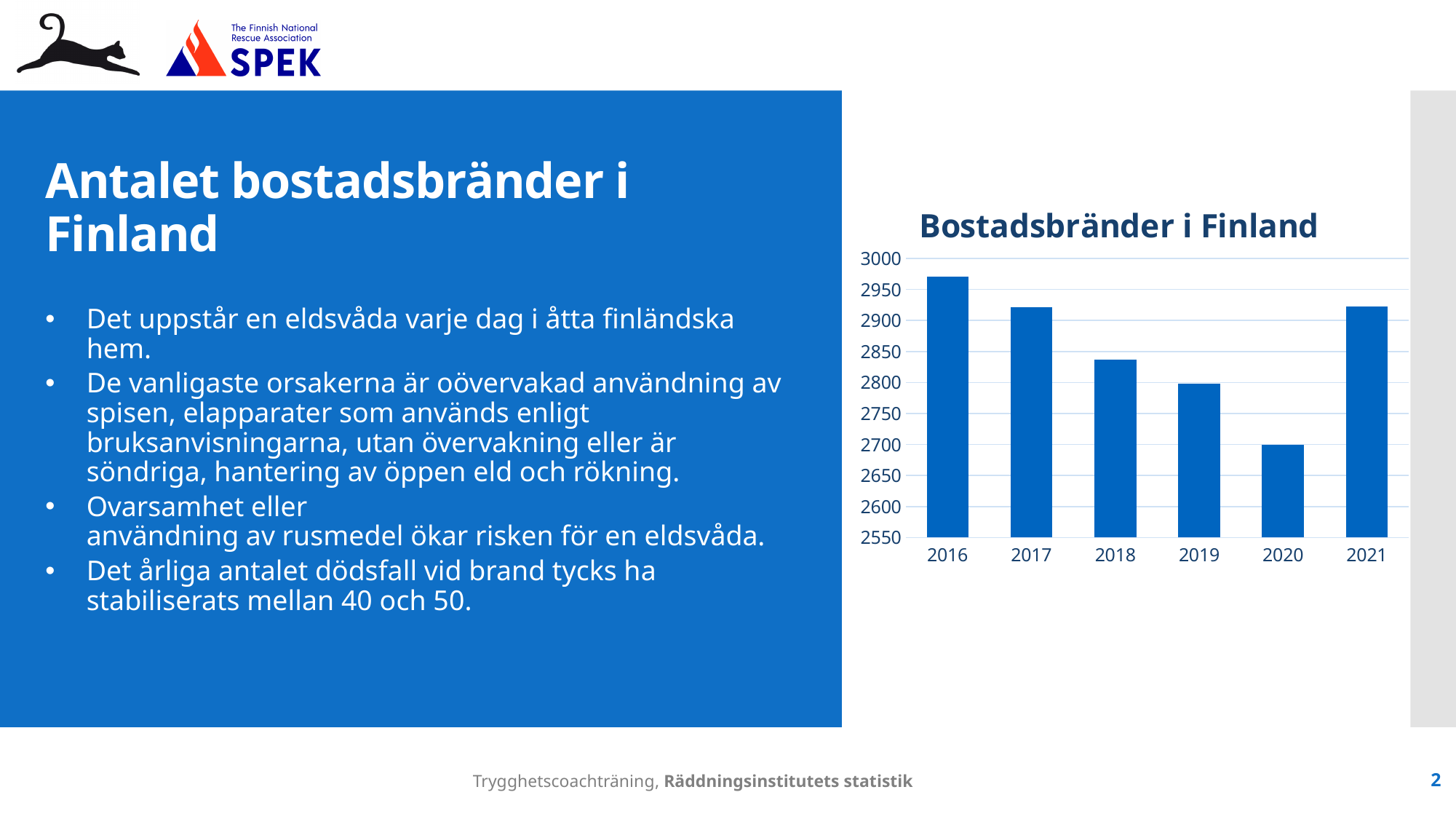
Which year has the larger value, 2018 or 2019? 2018 Do the values rise or fall from 2016 to 2020? fall What kind of chart is shown on the slide? bar chart Which year has the larger value, 2016 or 2020? 2016 Is the value for 2021 greater or less than 2900? greater Which year has the highest number of residential fires in the chart? 2016 Is the value for 2018 greater or less than 2800? greater How many years are shown on the x axis of the chart? 6 Is the value for 2020 greater or less than 2750? less Which year has the lowest number of residential fires in the chart? 2020 What is the title of the chart? Bostadsbränder i Finland